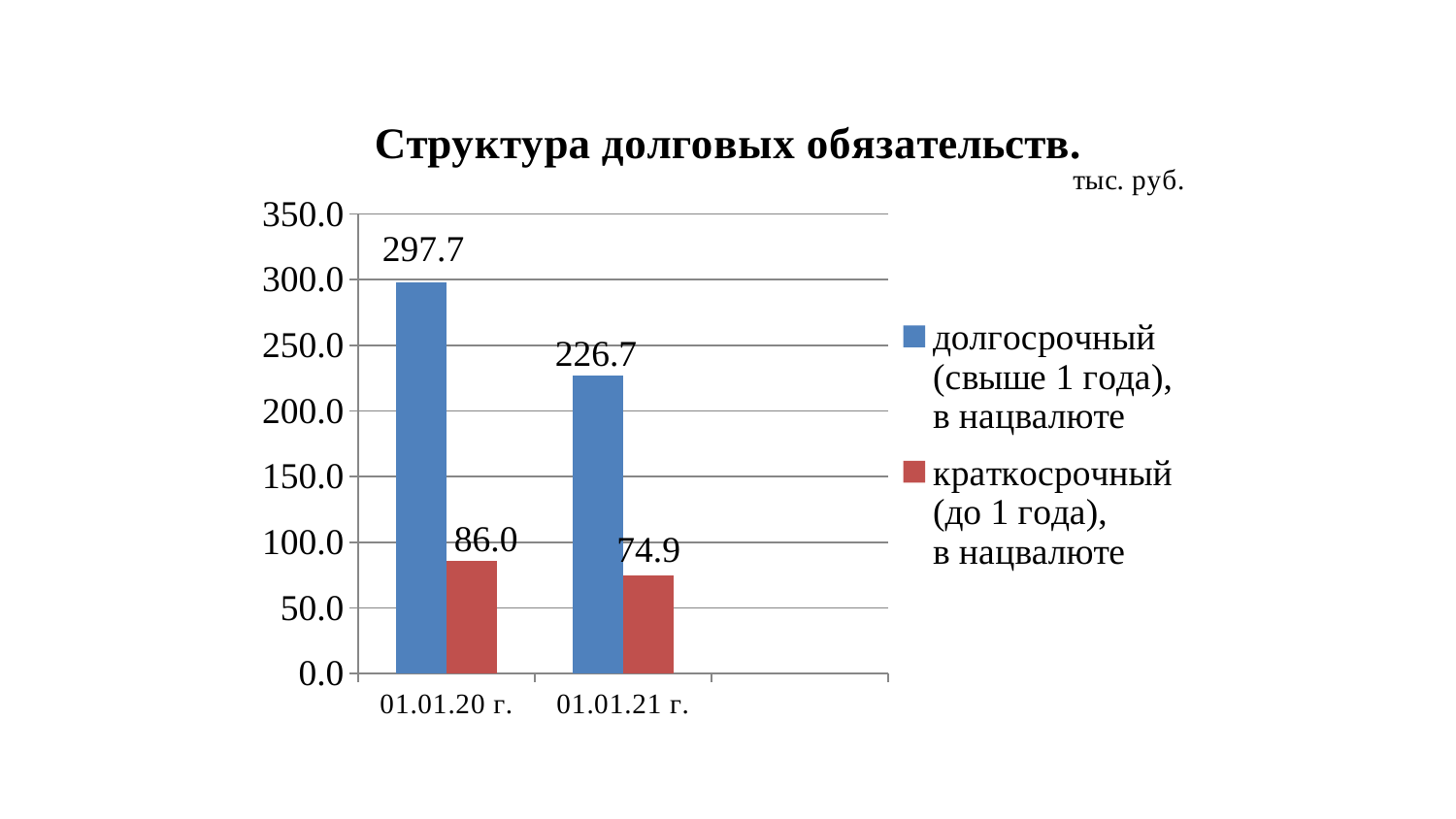
How many series does the legend list? 2 What kind of chart is shown on the slide? bar chart What is the value of краткосрочный (до 1 года), в нацвалюте for 01.01.20 г.? 86.0 What is the difference between the долгосрочный values for 01.01.20 г. and 01.01.21 г.? 71.0 What is the value of краткосрочный (до 1 года), в нацвалюте for 01.01.21 г.? 74.9 What is the value of долгосрочный (свыше 1 года), в нацвалюте for 01.01.21 г.? 226.7 What is the value of долгосрочный (свыше 1 года), в нацвалюте for 01.01.20 г.? 297.7 Which date has the highest value for долгосрочный (свыше 1 года), в нацвалюте? 01.01.20 г. How many dates are shown on the x axis? 2 Which is larger: краткосрочный for 01.01.20 г. or краткосрочный for 01.01.21 г.? 01.01.20 г. What is the title of the chart? Структура долговых обязательств. Which date has the lowest value for краткосрочный (до 1 года), в нацвалюте? 01.01.21 г.